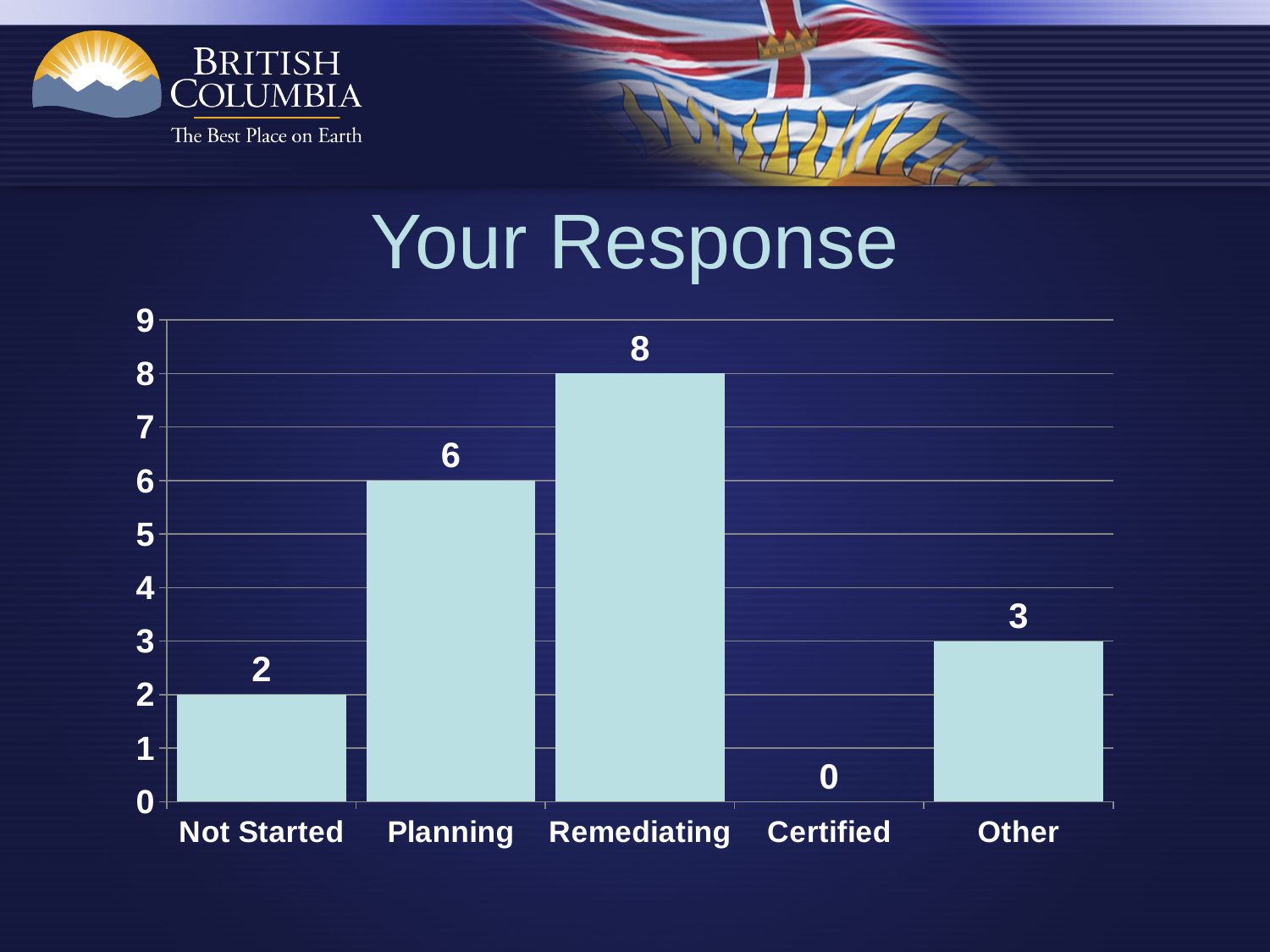
What is the title of the chart? Your Response What kind of chart is shown on the slide? bar chart Is the value for Planning greater or less than 5? greater What is the value for Certified? 0 Which category has the lowest value? Certified What is the value for Not Started? 2 Which is larger, the value for Planning or the value for Other? Planning Which category has the highest value? Remediating What is the difference between the values for Remediating and Planning? 2 What is the value for Remediating? 8 How many categories are shown on the x axis? 5 What is the difference between the values for Other and Not Started? 1